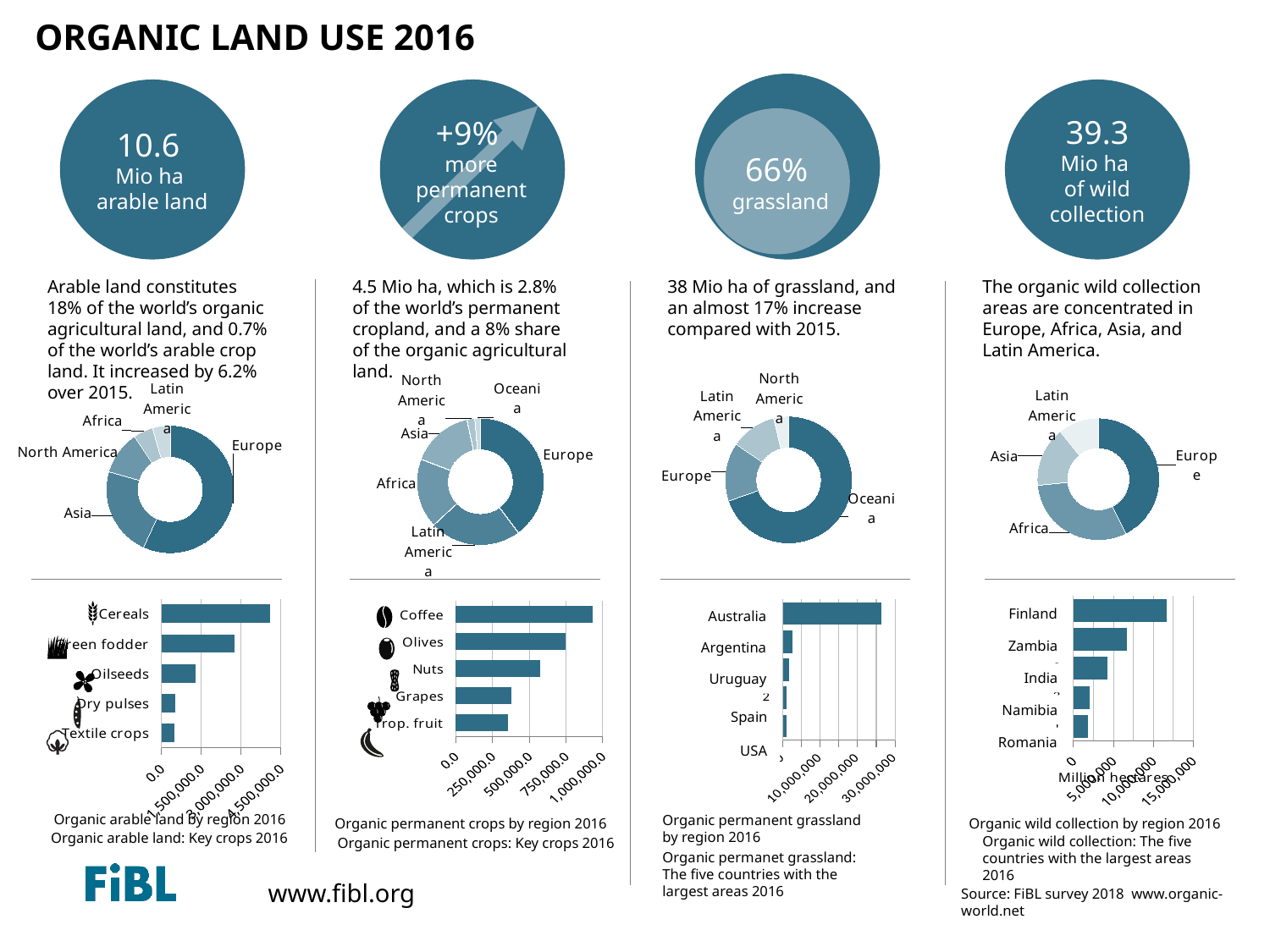
In the 'Organic permanent grassland: The five countries with the largest areas 2016' chart, which country has the largest area? Australia In the 'Organic permanent grassland: The five countries with the largest areas 2016' chart, is the value for Australia greater or less than 20,000,000? greater In the 'Organic wild collection: The five countries with the largest areas 2016' chart, which is larger, Zambia or Namibia? Zambia In the 'Organic permanent crops: Key crops 2016' bar chart, is the value for Coffee greater or less than 750,000.0? greater In the 'Organic wild collection: The five countries with the largest areas 2016' chart, is the value for Finland greater or less than 10,000,000? greater How many crops are shown in the 'Organic arable land: Key crops 2016' bar chart? 5 In the 'Organic permanent crops: Key crops 2016' bar chart, which crop has the largest area? Coffee In the 'Organic permanent crops: Key crops 2016' bar chart, which is larger, Olives or Nuts? Olives What kind of chart is 'Organic permanent grassland by region 2016'? Donut (pie) chart In the 'Organic permanent grassland by region 2016' donut chart, which region has the largest share? Oceania